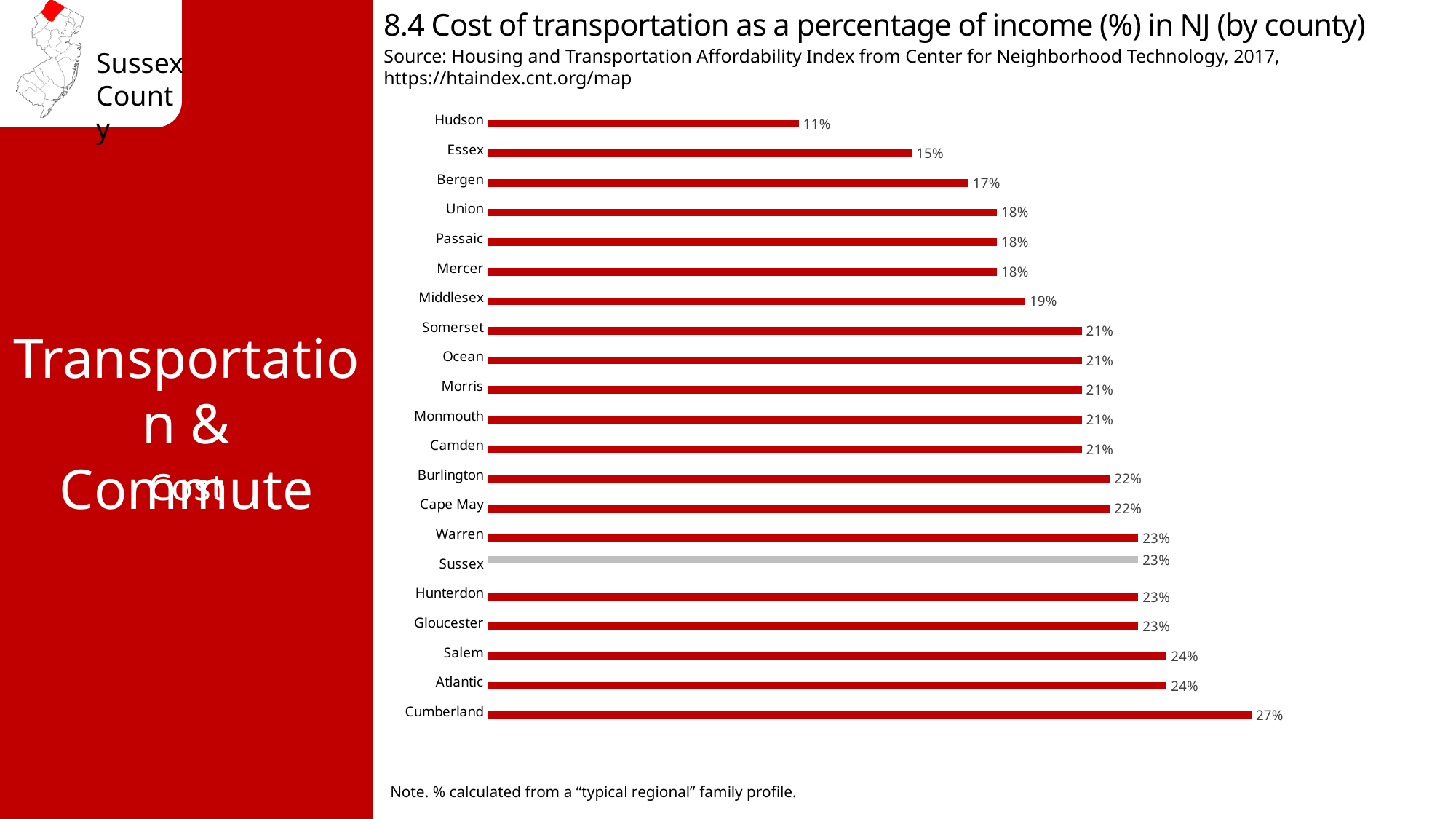
What is the difference in percentage points between Cumberland and Hudson? 16 What is the cost of transportation as a percentage of income for Sussex County? 23% What is the cost of transportation as a percentage of income for Hudson County? 11% Which county's bar is shown in grey instead of red? Sussex What is the difference in percentage points between Sussex and Essex? 8 Which county has the lowest cost of transportation as a percentage of income? Hudson What is the cost of transportation as a percentage of income for Middlesex County? 19% Which has a higher cost of transportation as a percentage of income, Essex or Somerset? Somerset How many counties are shown in the chart? 21 What type of chart is shown on the slide? Bar chart Which county has the highest cost of transportation as a percentage of income? Cumberland Which has a higher cost of transportation as a percentage of income, Bergen or Salem? Salem